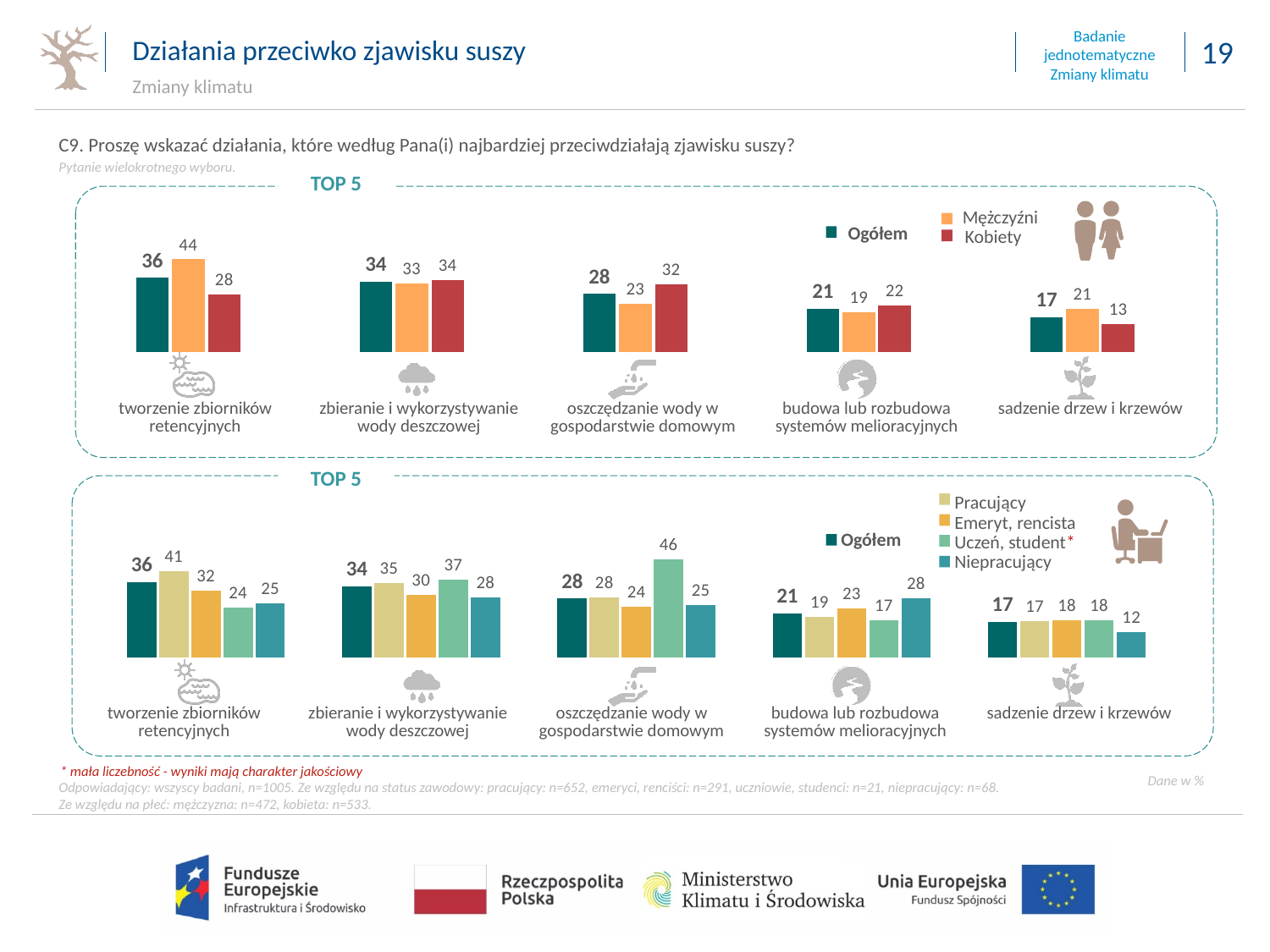
In the bottom chart, which series has the lowest value for 'sadzenie drzew i krzewów'? Niepracujący How many series does the legend of the bottom chart list? 5 In the top chart, what is the value for Mężczyźni for 'tworzenie zbiorników retencyjnych'? 44 In the top chart, what is the value for Kobiety for 'sadzenie drzew i krzewów'? 13 In the top chart, what is the difference between the Mężczyźni and Kobiety values for 'tworzenie zbiorników retencyjnych'? 16 In the bottom chart, what is the value for Uczeń, student for 'oszczędzanie wody w gospodarstwie domowym'? 46 In the top chart, which is larger for 'oszczędzanie wody w gospodarstwie domowym': the Mężczyźni value or the Kobiety value? Kobiety What type of chart is the top chart? bar chart How many categories are shown in the bottom chart? 5 In the top chart, which category has the highest Ogółem value? tworzenie zbiorników retencyjnych In the bottom chart, what is the value for Niepracujący for 'budowa lub rozbudowa systemów melioracyjnych'? 28 How many series does the legend of the top chart list? 3